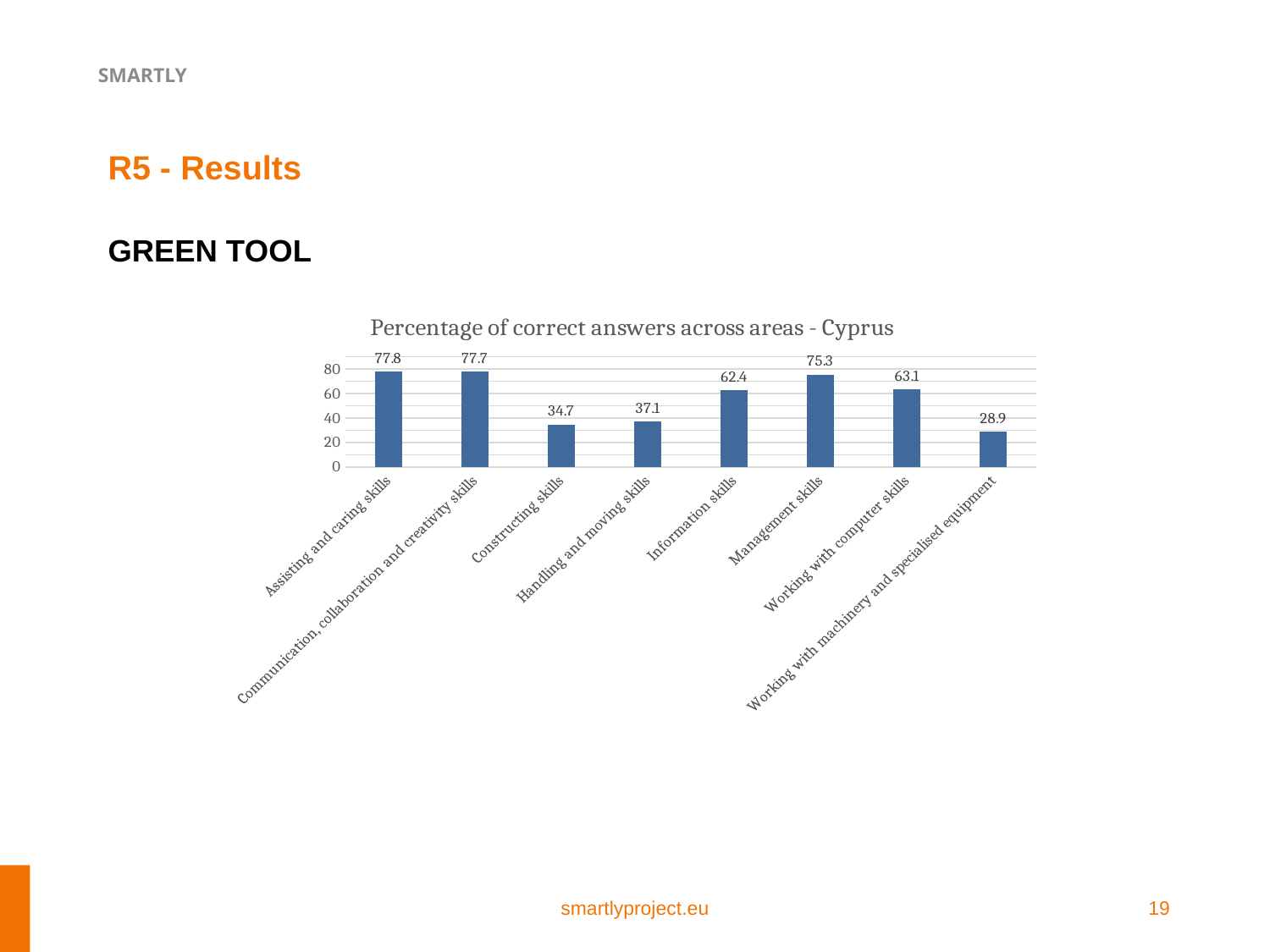
What is the value for Working with machinery and specialised equipment? 28.9 What is the value for Information skills? 62.4 What is the difference between the values for Working with computer skills and Information skills? 0.7 What is the difference between the values for Handling and moving skills and Constructing skills? 2.4 Which is larger, the value for Management skills or the value for Working with computer skills? Management skills Is the value for Handling and moving skills greater or less than 40? less What kind of chart is shown on the slide? bar chart How many categories are shown on the x axis? 8 What is the title of the chart? Percentage of correct answers across areas - Cyprus What is the value for Management skills? 75.3 Which category has the lowest value? Working with machinery and specialised equipment What is the value for Constructing skills? 34.7